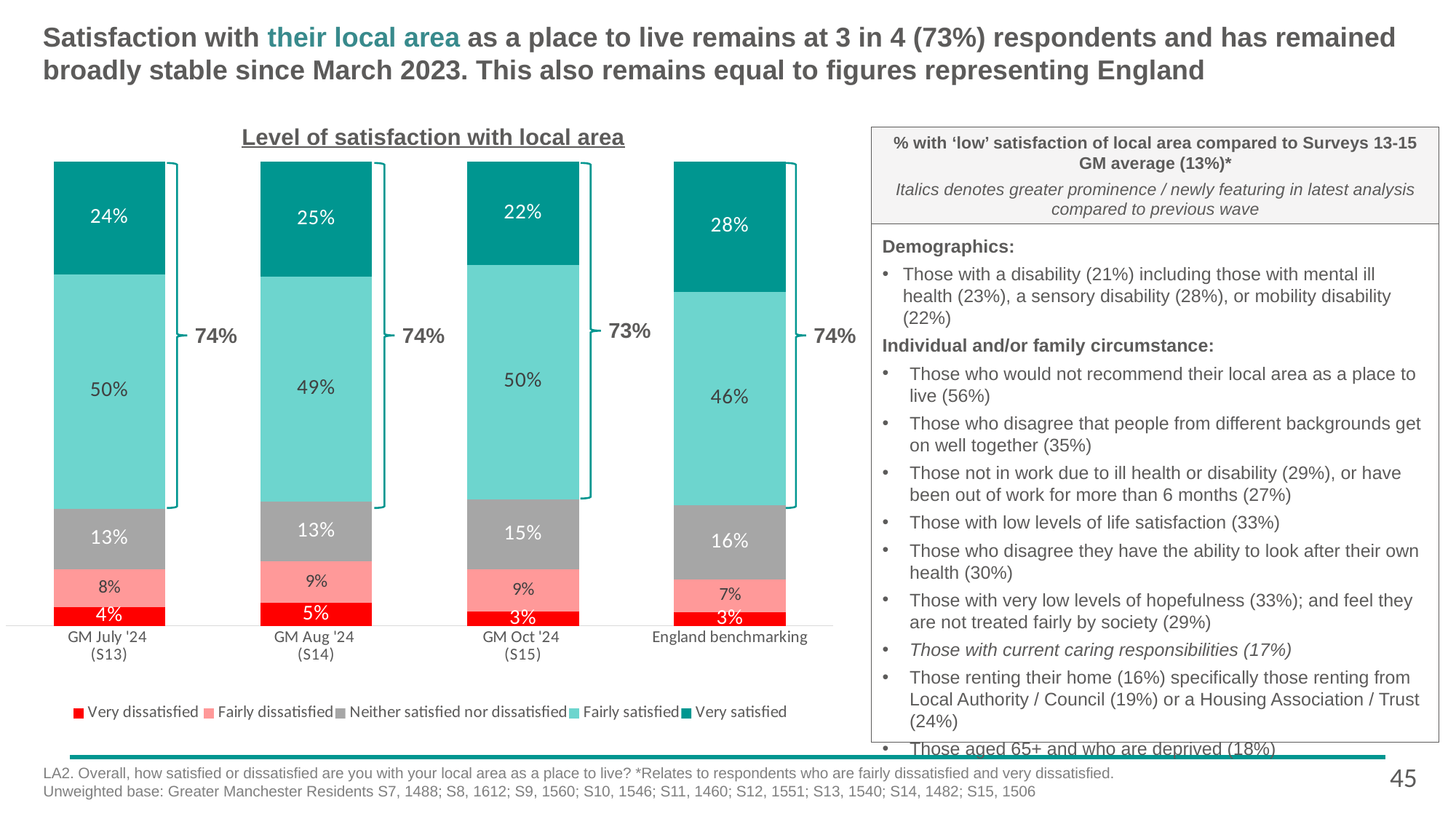
What is the 'Very dissatisfied' value for GM Aug '24 (S14)? 5% What is the 'Fairly satisfied' value for England benchmarking? 46% What is the 'Neither satisfied nor dissatisfied' value for GM July '24 (S13)? 13% Which category has the highest 'Very satisfied' value? England benchmarking Which is larger: the 'Neither satisfied nor dissatisfied' value for GM Oct '24 (S15) or for GM Aug '24 (S14)? GM Oct '24 (S15) What is the 'Very satisfied' value for GM Oct '24 (S15)? 22% Which category has the lowest 'Fairly dissatisfied' value? England benchmarking What is the combined satisfied (Fairly satisfied plus Very satisfied) percentage shown by the bracket for GM Oct '24 (S15)? 73% How many series does the legend list? 5 What type of chart is shown on the slide? Stacked bar chart What is the difference between the 'Fairly satisfied' values for GM Oct '24 (S15) and England benchmarking? 4% How many categories are shown along the x axis? 4